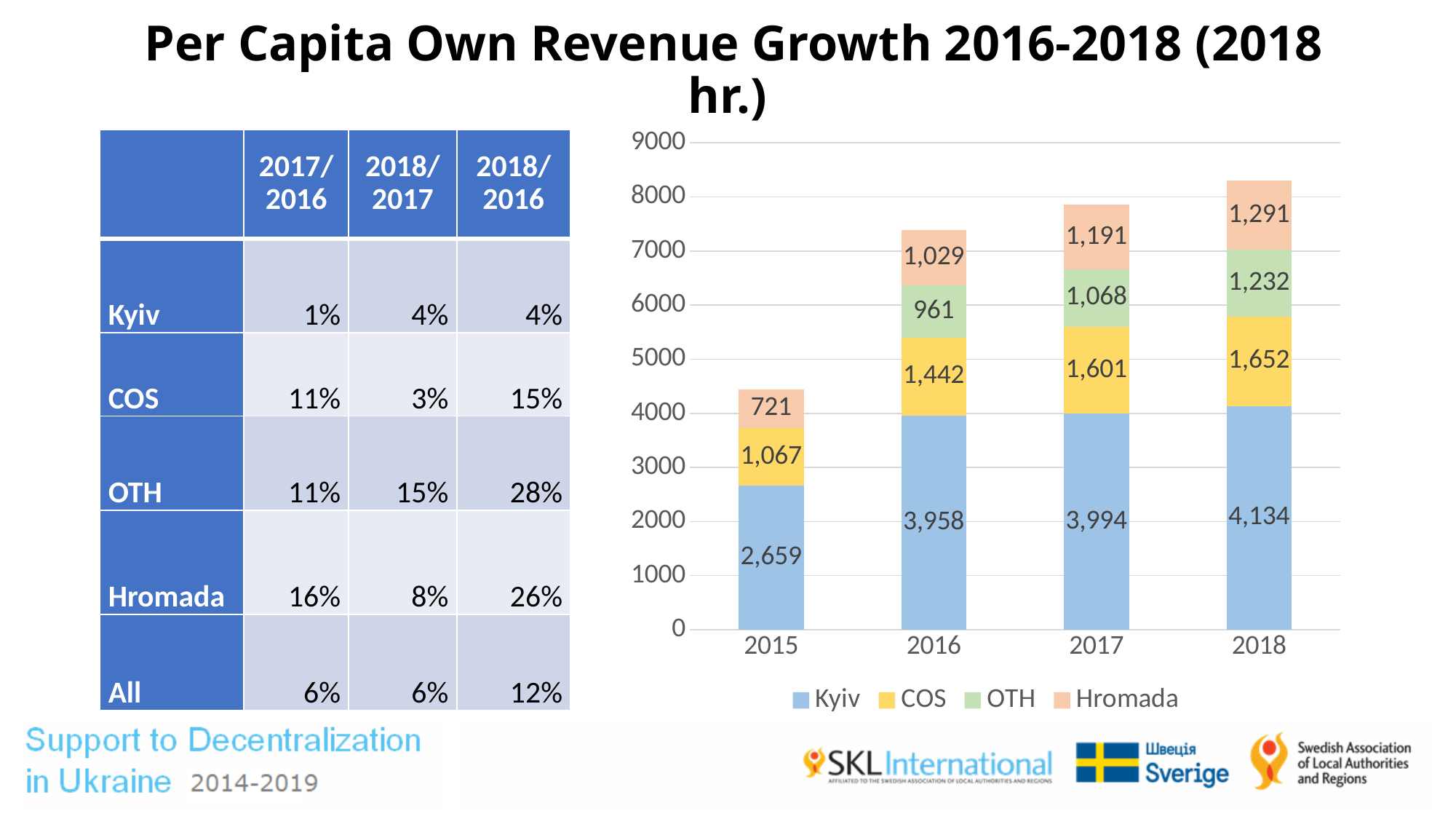
What type of chart is shown on the slide? Stacked bar chart How many years are shown on the x axis? 4 What is the difference between the Kyiv value in 2018 and in 2015? 1,475 What is the total of the stacked bar for 2016? 7,390 What is the value for Kyiv in 2018? 4,134 In which year is the Kyiv value highest? 2018 In which year is the Kyiv value lowest? 2015 What is the value for COS in 2016? 1,442 Does the total stacked bar height rise or fall from 2015 to 2018? Rise What is the value for OTH in 2017? 1,068 What is the value for Hromada in 2015? 721 How many series does the legend list? 4